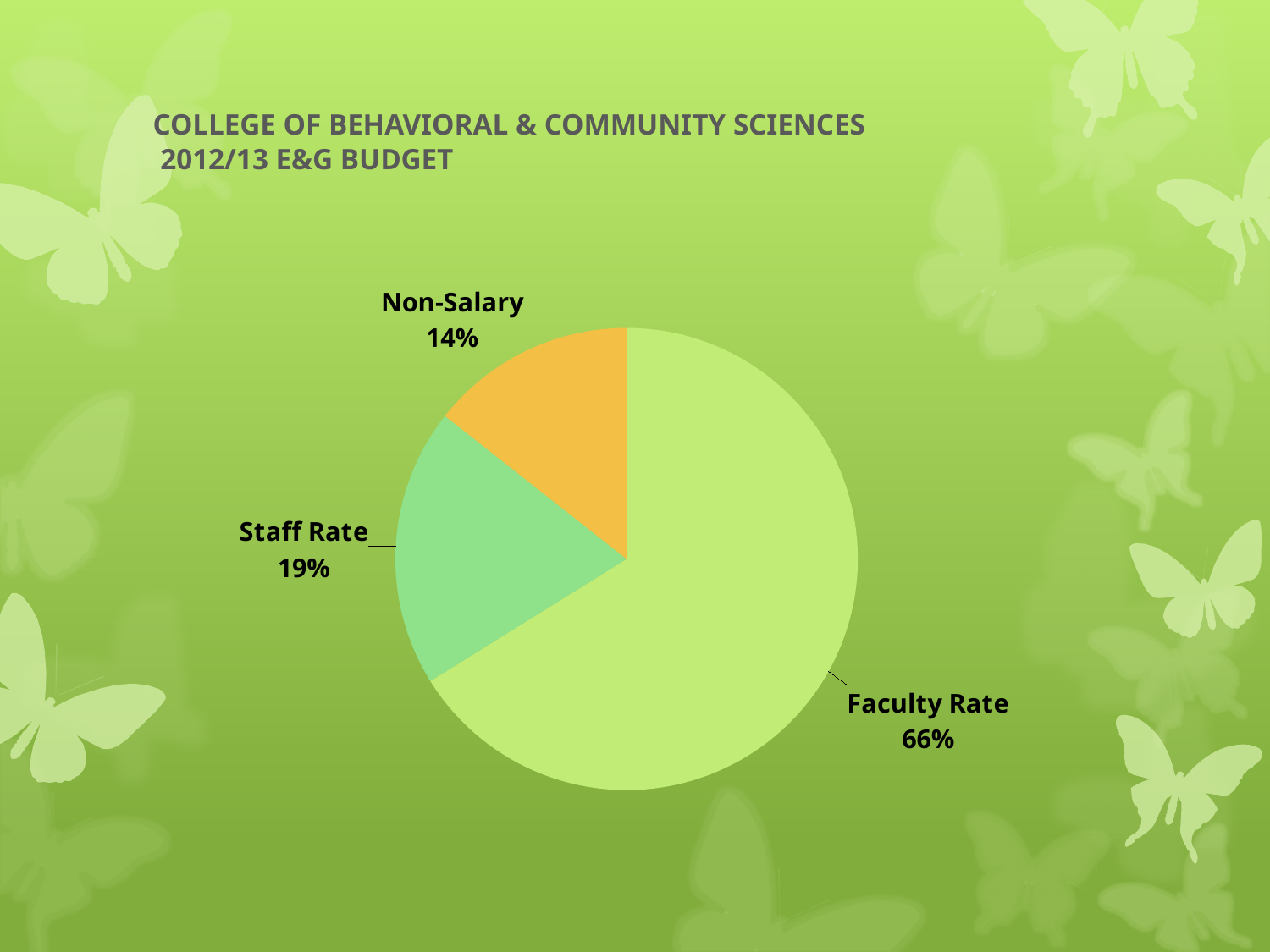
What is the title of the slide? College of Behavioral & Community Sciences 2012/13 E&G Budget What colour is the Non-Salary slice? Orange Which is larger, Staff Rate or Non-Salary? Staff Rate What kind of chart is shown on the slide? Pie chart What is the difference in percentage points between Faculty Rate and Staff Rate? 47 How many categories are shown in the pie chart? 3 What share of the budget is Non-Salary? 14% Which category has the smallest share of the pie? Non-Salary Which category has the largest share of the pie? Faculty Rate What is the difference in percentage points between Staff Rate and Non-Salary? 5 What share of the budget is Staff Rate? 19% What share of the budget is Faculty Rate? 66%